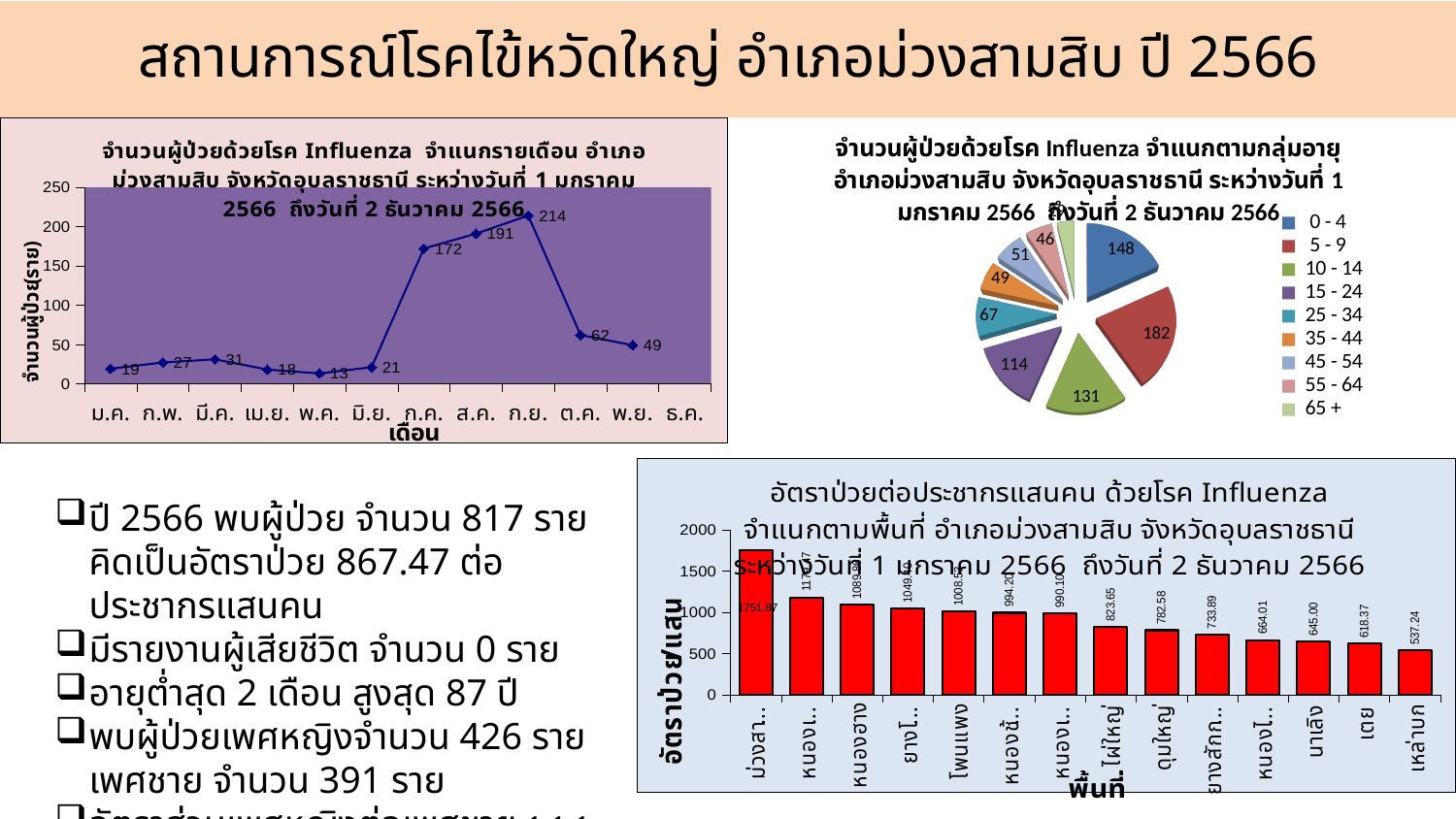
In the bar chart of Influenza rate per 100,000 population by area, which area has the lowest rate? เหล่าบก In the bar chart of Influenza rate per 100,000 population by area, what is the value for เหล่าบก? 537.24 In the line chart of monthly Influenza cases, which month has the highest number of cases? ก.ย. In the pie chart of Influenza cases by age group, which age group has the largest slice? 5 - 9 What kind of chart is the top-left chart showing Influenza cases by month? Line chart In the bar chart of Influenza rate per 100,000 population by area, is the value for หนองฮาง greater or less than 1000? greater In the line chart of monthly Influenza cases, which month has the lowest number of cases? พ.ค. In the line chart of monthly Influenza cases, what is the difference between the values for ส.ค. and ก.ค.? 19 In the pie chart of Influenza cases by age group, how many cases are in the 5 - 9 group? 182 In the bar chart of Influenza rate per 100,000 population by area, what is the difference between the values for ไผ่ใหญ่ and ดุมใหญ่? 41.07 In the line chart of monthly Influenza cases, how many cases were recorded in ก.ย.? 214 How many age groups does the legend of the pie chart list? 9